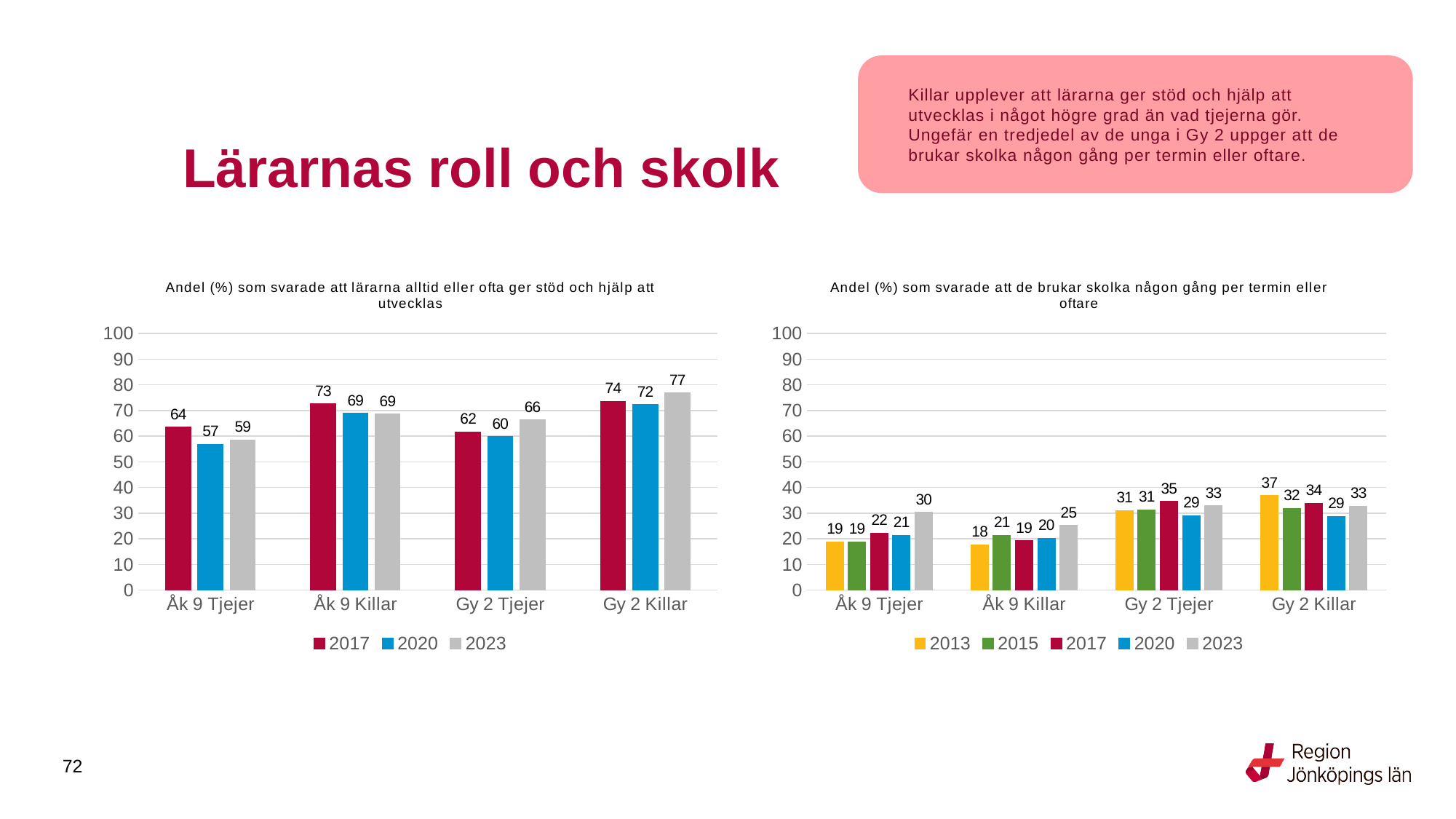
In the right chart (brukar skolka), which category has the highest value for 2013? Gy 2 Killar In the left chart (lärarna ger stöd och hjälp), what is the value for Åk 9 Tjejer in 2017? 64 In the left chart (lärarna ger stöd och hjälp), which category has the lowest value for 2023? Åk 9 Tjejer What type of chart is the right chart (brukar skolka)? bar chart In the left chart (lärarna ger stöd och hjälp), which category has the highest value for 2020? Gy 2 Killar In the left chart (lärarna ger stöd och hjälp), what is the value for Gy 2 Killar in 2023? 77 In the right chart (brukar skolka), what is the value for Åk 9 Killar in 2023? 25 In the right chart (brukar skolka), what is the value for Gy 2 Tjejer in 2017? 35 How many series does the legend of the left chart (lärarna ger stöd och hjälp) list? 3 How many series does the legend of the right chart (brukar skolka) list? 5 In the left chart (lärarna ger stöd och hjälp), what is the difference between the 2017 and 2020 values for Åk 9 Tjejer? 7 In the right chart (brukar skolka), is the 2023 value for Åk 9 Tjejer larger or smaller than the 2023 value for Åk 9 Killar? larger